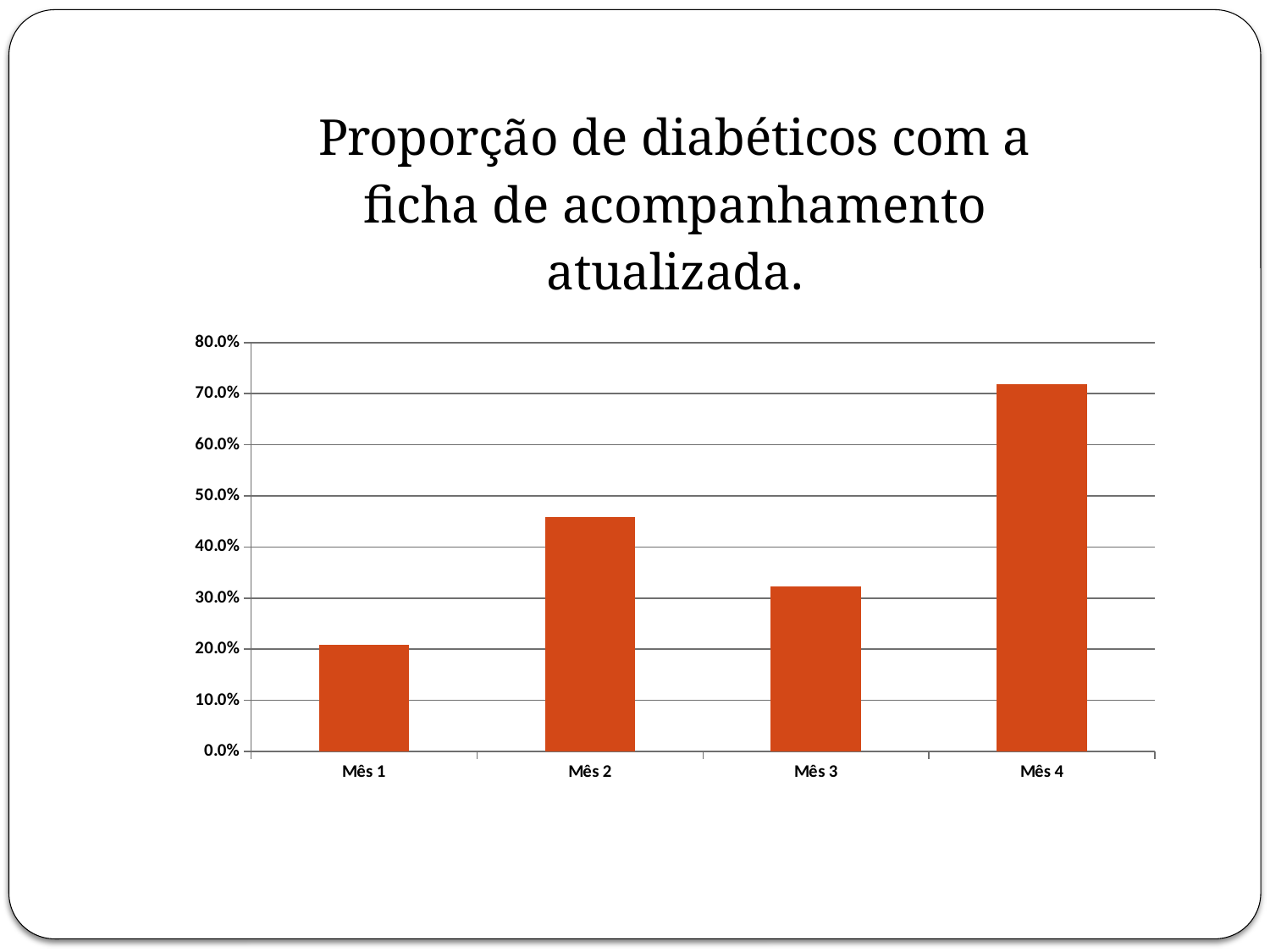
What is the maximum value shown on the vertical axis? 80.0% Is the value for Mês 3 greater or less than 40.0%? less Which month has the highest proportion of diabetics with an updated follow-up record? Mês 4 Is the value for Mês 1 greater or less than 30.0%? less Is the value for Mês 4 greater or less than 70.0%? greater Which is larger, the value for Mês 1 or the value for Mês 4? Mês 4 How many categories (months) are plotted on the chart? 4 What kind of chart is shown on the slide? bar chart What is the title of the chart? Proporção de diabéticos com a ficha de acompanhamento atualizada. Which is larger, the value for Mês 2 or the value for Mês 3? Mês 2 Which month has the lowest proportion of diabetics with an updated follow-up record? Mês 1